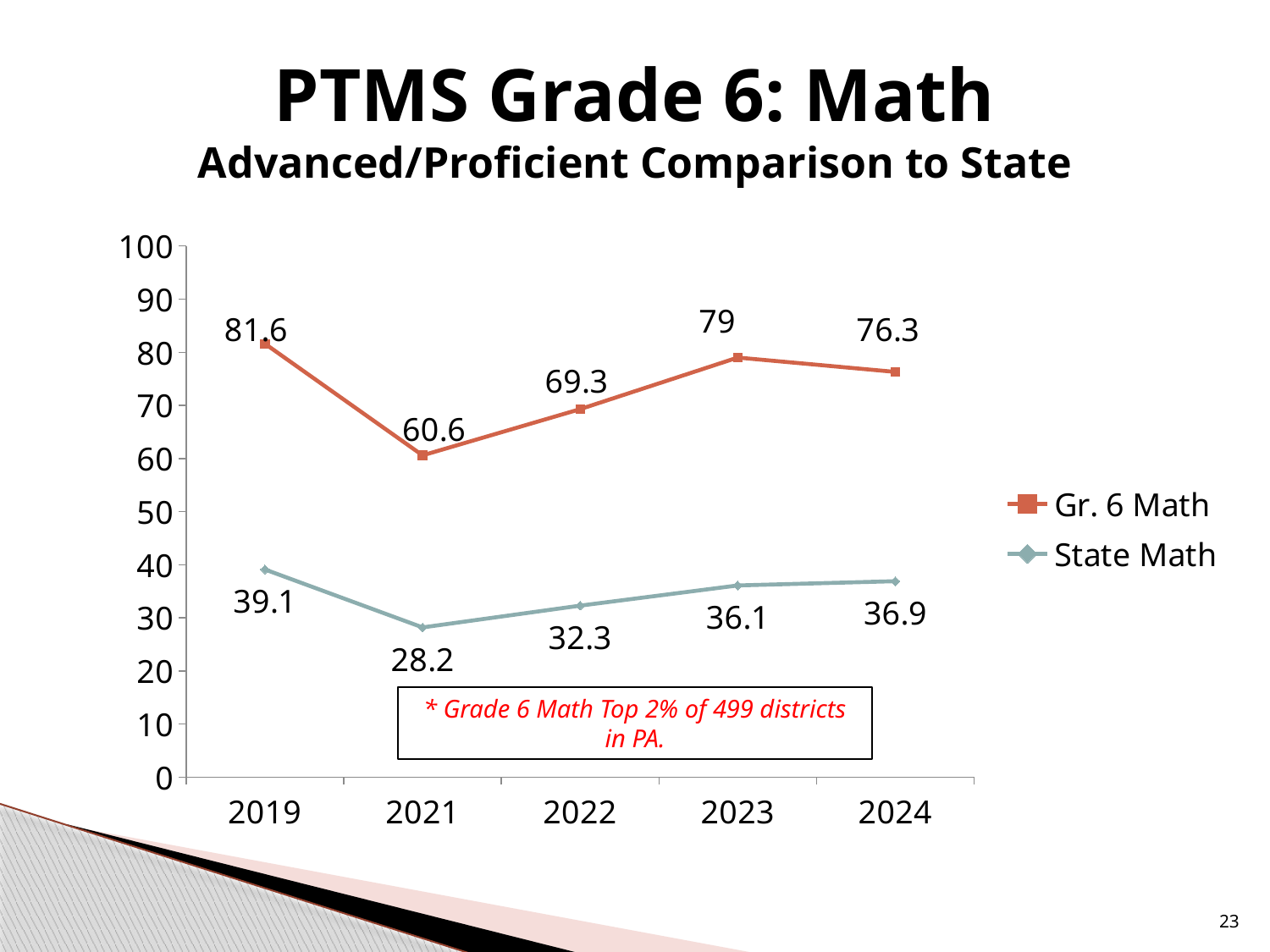
How many years are shown on the x axis? 5 What is the State Math value for 2021? 28.2 Which is larger, the State Math value for 2022 or for 2024? 2024 Does the State Math value rise or fall from 2021 to 2024? Rise In which year is the Gr. 6 Math value lowest? 2021 What is the difference between the Gr. 6 Math and State Math values in 2023? 42.9 What is the Gr. 6 Math value for 2024? 76.3 What is the title of the chart on the slide? PTMS Grade 6: Math Advanced/Proficient Comparison to State In which year is the Gr. 6 Math value highest? 2019 What kind of chart is shown on the slide? Line chart What is the Gr. 6 Math value for 2019? 81.6 How many series does the legend list? 2